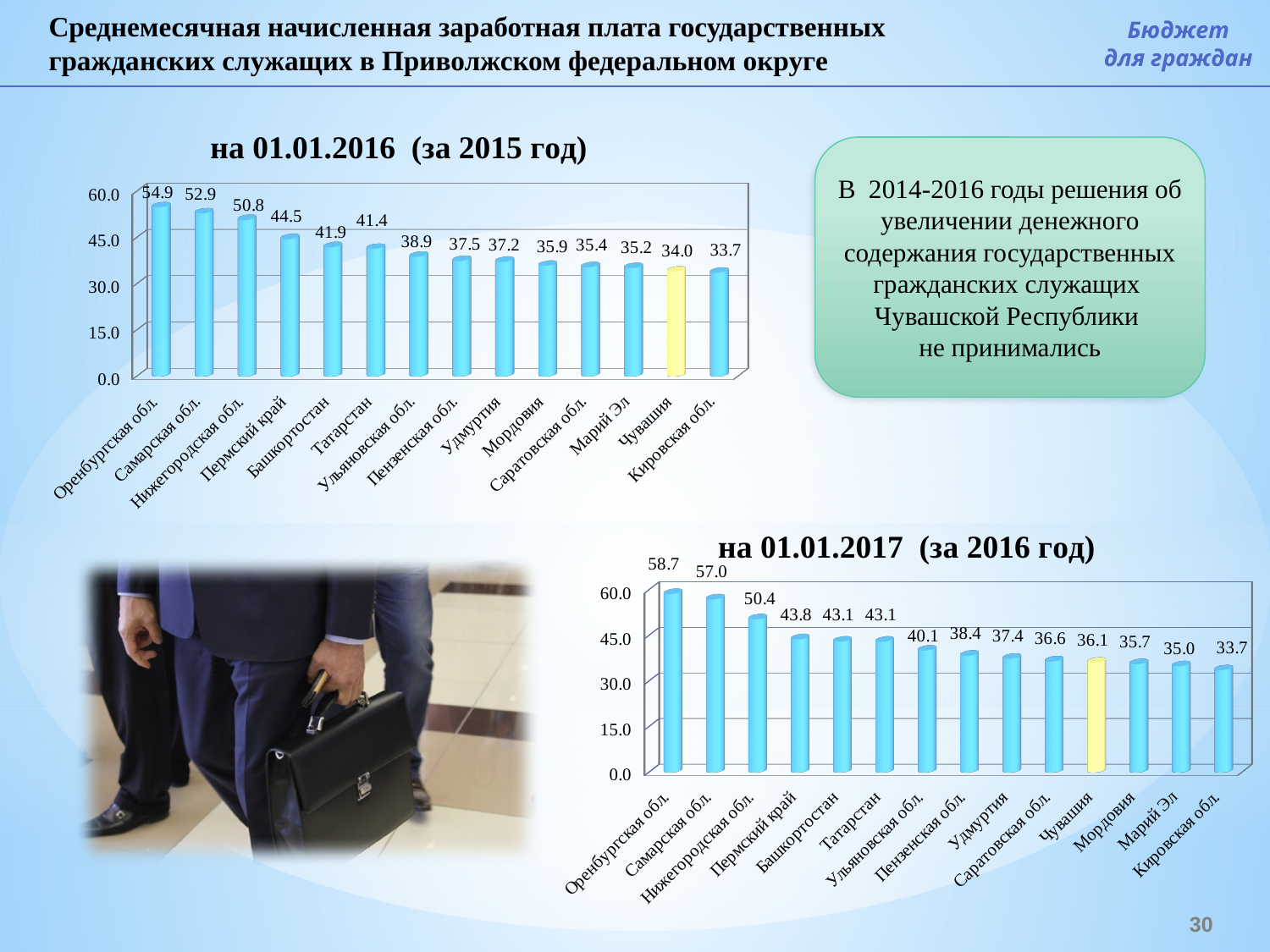
In the chart 'на 01.01.2016 (за 2015 год)', what is the value for Чувашия? 34.0 In the chart 'на 01.01.2017 (за 2016 год)', which region has the lowest value? Кировская обл. In the chart 'на 01.01.2016 (за 2015 год)', what is the difference between the values for Оренбургская обл. and Самарская обл.? 2.0 In the chart 'на 01.01.2017 (за 2016 год)', what is the difference between the values for Оренбургская обл. and Кировская обл.? 25.0 How many regions are shown in the chart 'на 01.01.2017 (за 2016 год)'? 14 In the chart 'на 01.01.2016 (за 2015 год)', which region has the highest value? Оренбургская обл. In the chart 'на 01.01.2017 (за 2016 год)', do the values rise or fall from left to right? fall In the chart 'на 01.01.2016 (за 2015 год)', which region's bar is highlighted in yellow? Чувашия In the chart 'на 01.01.2017 (за 2016 год)', which is larger: the value for Нижегородская обл. or the value for Пермский край? Нижегородская обл. What type of chart is 'на 01.01.2016 (за 2015 год)'? bar chart In the chart 'на 01.01.2017 (за 2016 год)', what is the value for Чувашия? 36.1 In the chart 'на 01.01.2016 (за 2015 год)', is the value for Татарстан greater or less than 30.0? greater